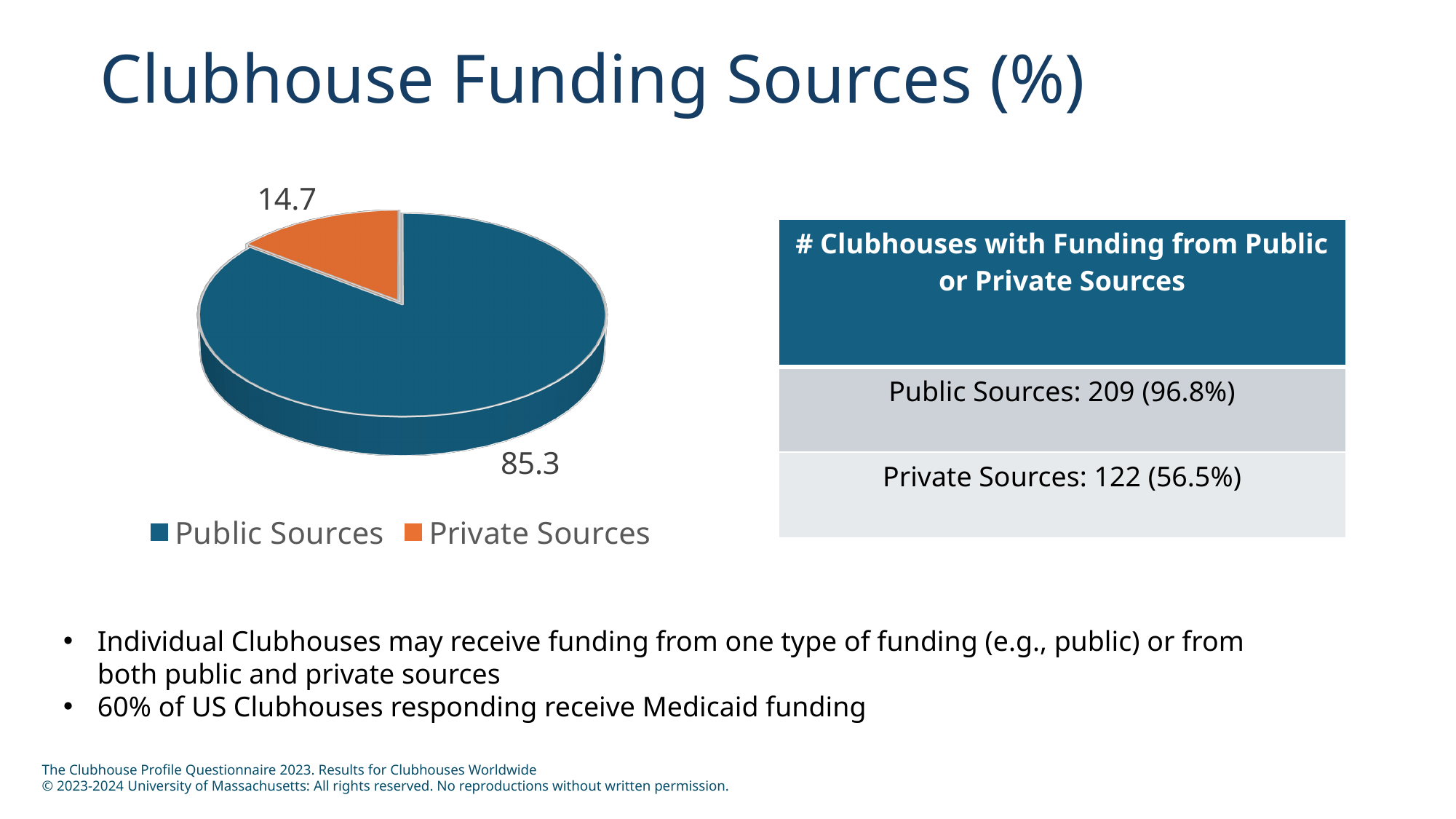
Which slice of the pie chart is the smallest? Private Sources What colour is the Private Sources slice in the pie chart? orange What is the difference between the Public Sources and Private Sources values in the pie chart? 70.6 What is the title of the slide containing the pie chart? Clubhouse Funding Sources (%) What is the total of the two slice values shown in the pie chart? 100 What kind of chart is shown on the slide? pie chart Which slice of the pie chart is the largest? Public Sources How many entries does the legend of the pie chart list? 2 What is the value for Private Sources in the pie chart? 14.7 Which is larger in the pie chart, Public Sources or Private Sources? Public Sources How many slices does the pie chart have? 2 What is the value for Public Sources in the pie chart? 85.3